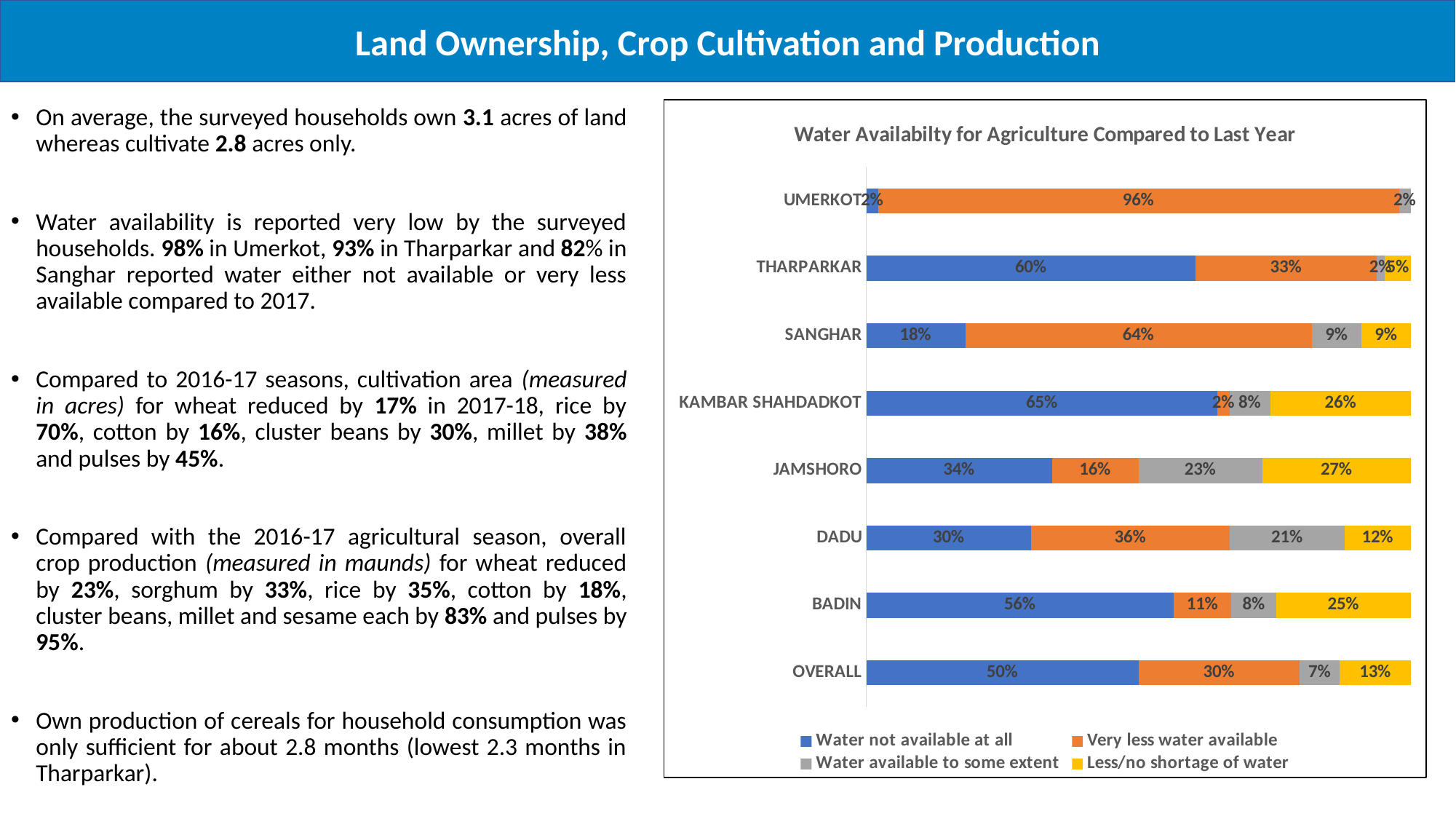
What is the title of the chart? Water Availabilty for Agriculture Compared to Last Year How many series does the legend list in the Water Availability chart? 4 Which district has the lowest 'Water not available at all' value? Umerkot What is the Overall value for 'Water available to some extent'? 7% What percentage of households in Umerkot reported very less water available? 96% Which is larger: the 'Less/no shortage of water' value for Badin or for Dadu? Badin What type of chart is shown on the slide? Stacked bar chart What is the difference between the 'Water not available at all' values for Badin and Dadu? 26% Which district has the highest 'Very less water available' value? Umerkot What is the 'Water not available at all' value for Kambar Shahdadkot? 65% How many districts/categories are shown on the y axis of the chart? 8 What is the 'Less/no shortage of water' value for Jamshoro? 27%